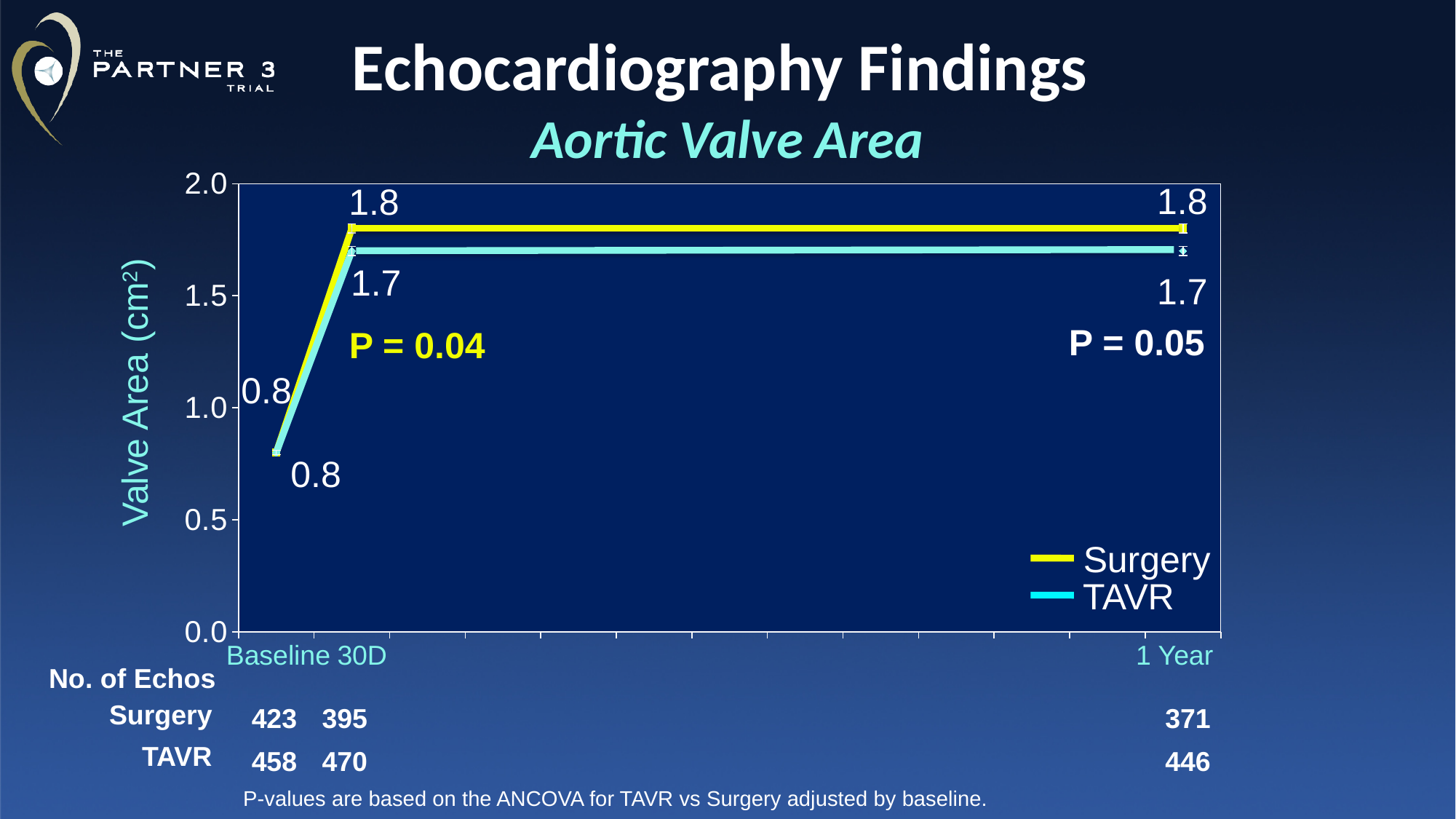
What is the P-value shown at 1 Year? P = 0.05 How many series does the legend list? 2 Which series has the larger valve area at 30D, Surgery or TAVR? Surgery At which time point is the TAVR valve area lowest? Baseline What is the aortic valve area for TAVR at 1 Year? 1.7 Does the Surgery valve area rise or fall from Baseline to 30D? Rise How many time points are plotted on the x axis? 3 What is the aortic valve area for Surgery at 30D? 1.8 What colour is the Surgery line? Yellow What is the aortic valve area for Surgery at Baseline? 0.8 What kind of chart is shown? Line chart What is the difference between the Surgery and TAVR valve areas at 1 Year? 0.1